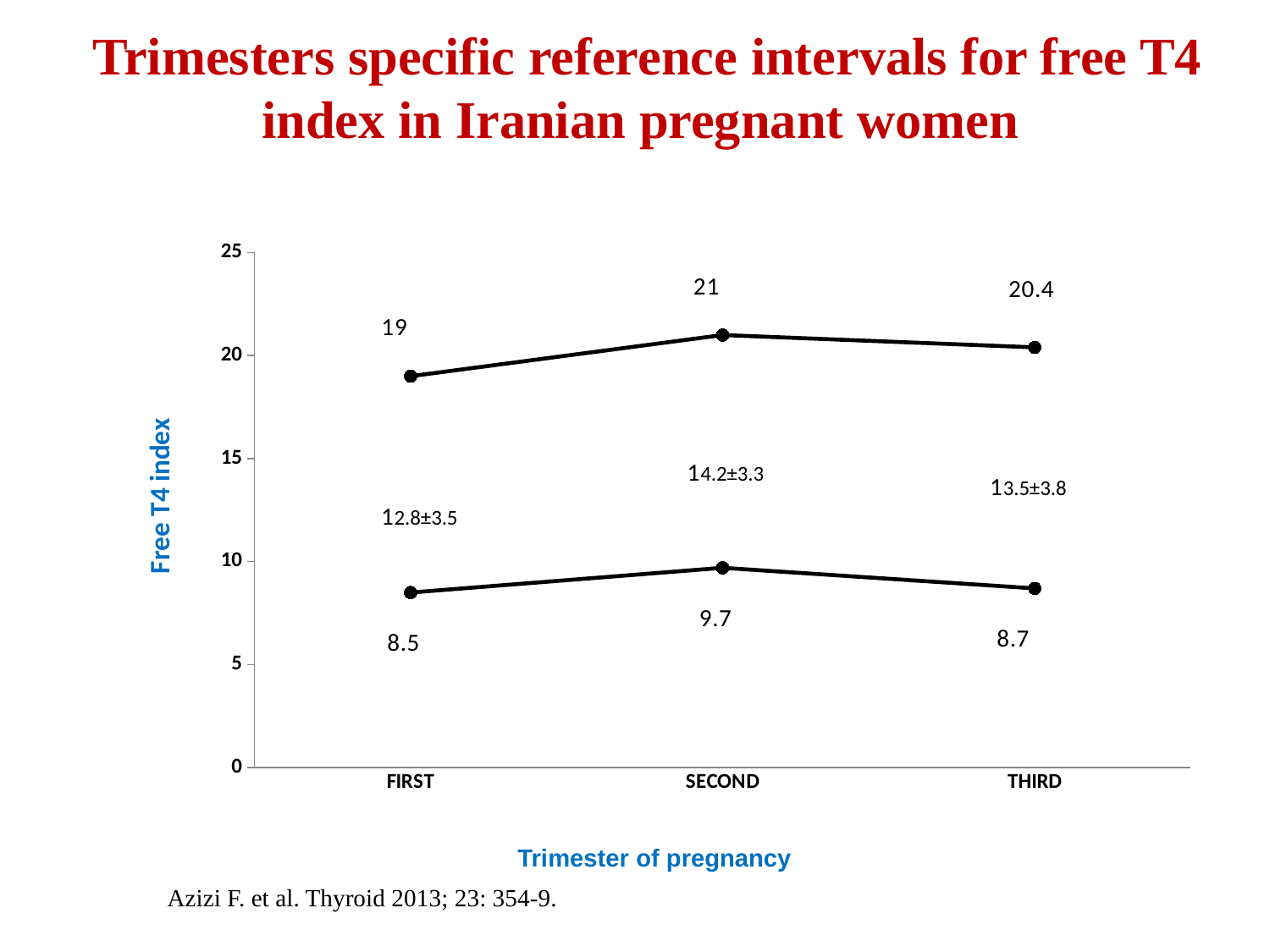
What kind of chart is shown on the slide? line chart Which trimester has the lowest value on the lower line? FIRST What is the value of the lower line for the FIRST trimester? 8.5 What is the mean ± SD value printed for the SECOND trimester? 14.2±3.3 How many trimester categories are shown on the x axis? 3 Which trimester has the highest value on the upper line? SECOND Which is larger, the upper line value for the FIRST trimester or for the THIRD trimester? THIRD What is the value of the upper line for the SECOND trimester? 21 What is the label of the y axis? Free T4 index What is the difference between the upper line value and the lower line value for the FIRST trimester? 10.5 What is the value of the lower line for the THIRD trimester? 8.7 What is the value of the upper line for the THIRD trimester? 20.4